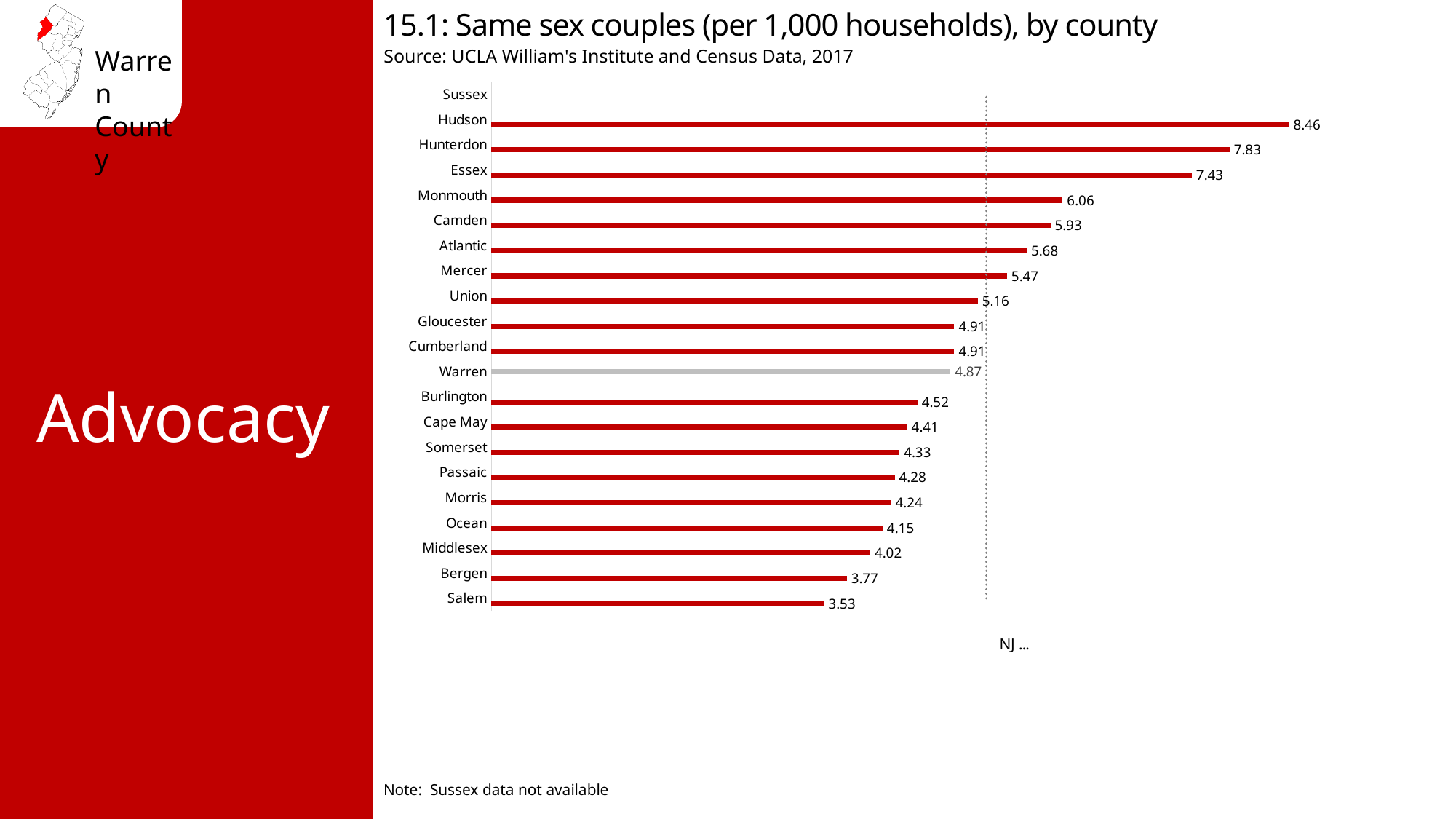
What is the value for Hudson? 8.46 Which is larger, the value for Essex or the value for Monmouth? Essex What is the difference between the values for Hudson and Hunterdon? 0.63 What is the value for Warren? 4.87 What kind of chart is shown? Bar chart What is the value for Mercer? 5.47 Which is larger, the value for Bergen or the value for Middlesex? Middlesex Which county has the lowest value shown? Salem What is the value for Salem? 3.53 Which county's data is noted as not available? Sussex What is the difference between the values for Warren and Salem? 1.34 Which county has the highest value? Hudson